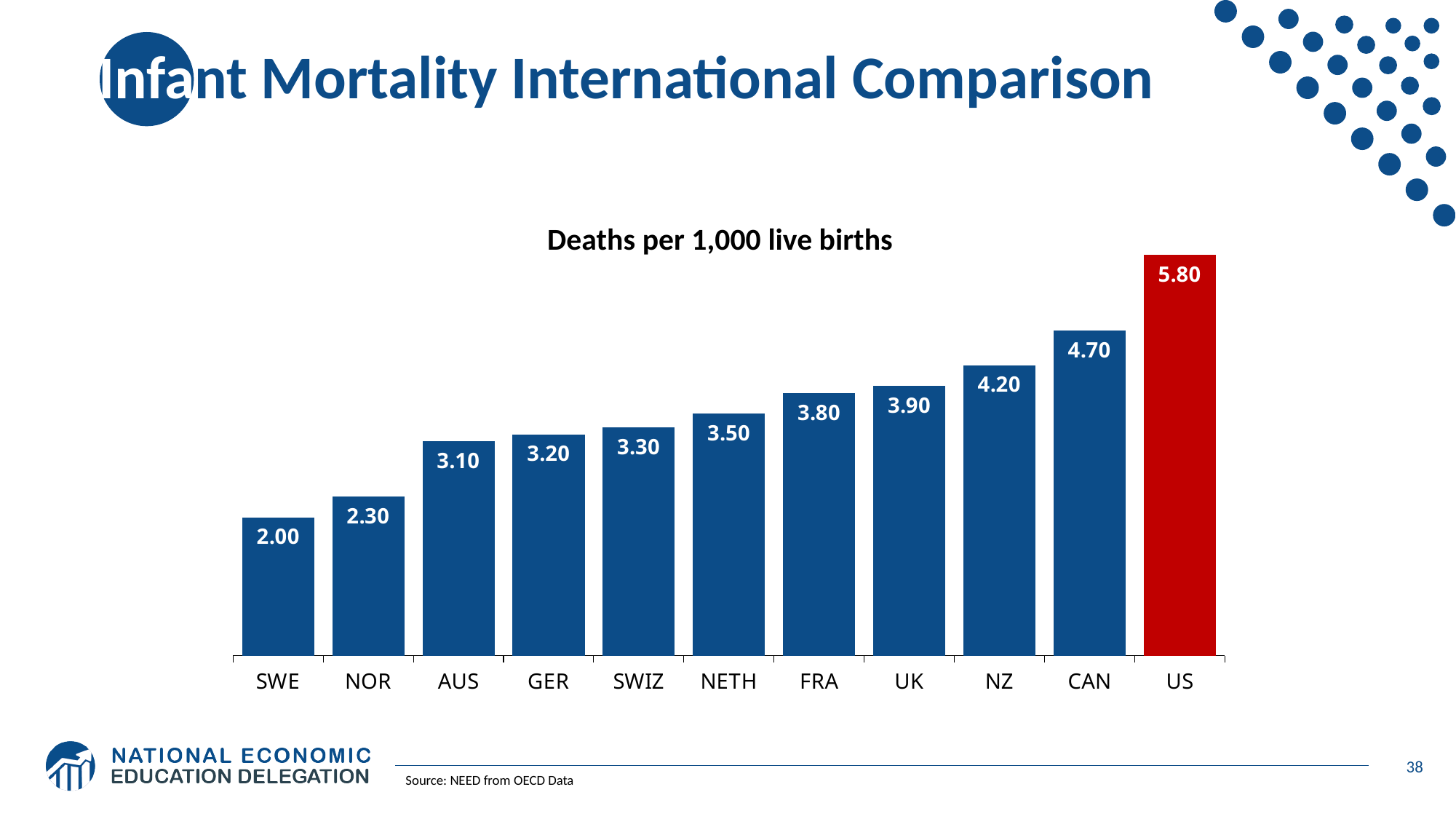
What is the title of the chart? Deaths per 1,000 live births What kind of chart is this? bar chart What is the value for GER? 3.20 How many countries are shown on the chart? 11 Which is larger, the value for FRA or the value for UK? UK What is the value for NZ? 4.20 Which country has the highest value? US What is the difference between the values for the US and CAN? 1.10 Which country has the lowest value? SWE What is the value for the US? 5.80 Do the values rise or fall from left to right along the x axis? rise What is the difference between the values for NOR and SWE? 0.30